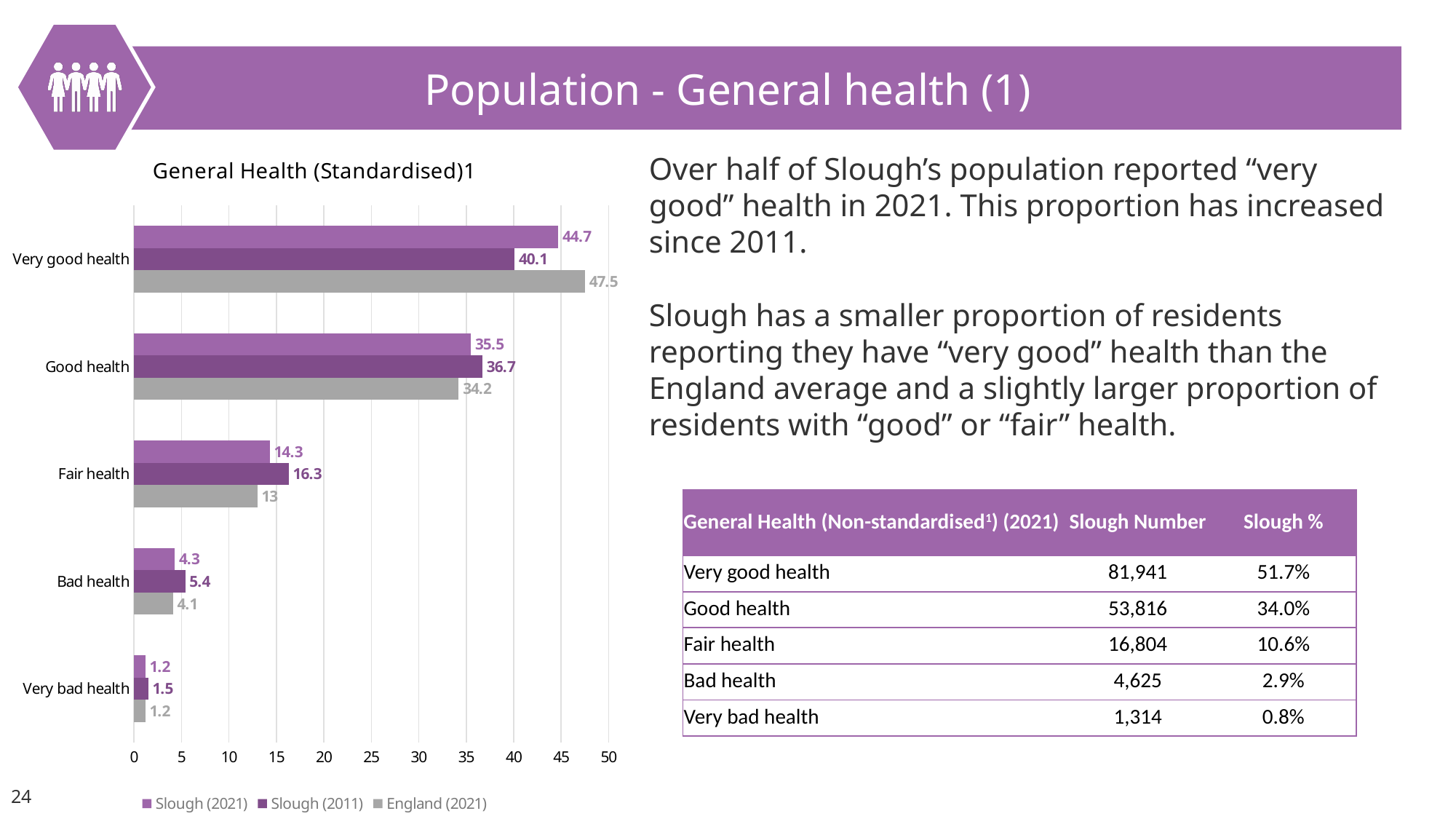
How many health categories are shown on the chart? 5 Which category has the highest Slough (2021) value? Very good health What is the Slough (2021) value for Very good health? 44.7 What is the England (2021) value for Good health? 34.2 Which is larger for Bad health: Slough (2011) or England (2021)? Slough (2011) How many series does the legend list? 3 Which category has the lowest England (2021) value? Very bad health What is the difference between the England (2021) and Slough (2021) values for Very good health? 2.8 What is the Slough (2011) value for Fair health? 16.3 What kind of chart is shown? Bar chart What is the title of the chart? General Health (Standardised)1 Is the Slough (2011) value for Very good health greater or less than 35? greater